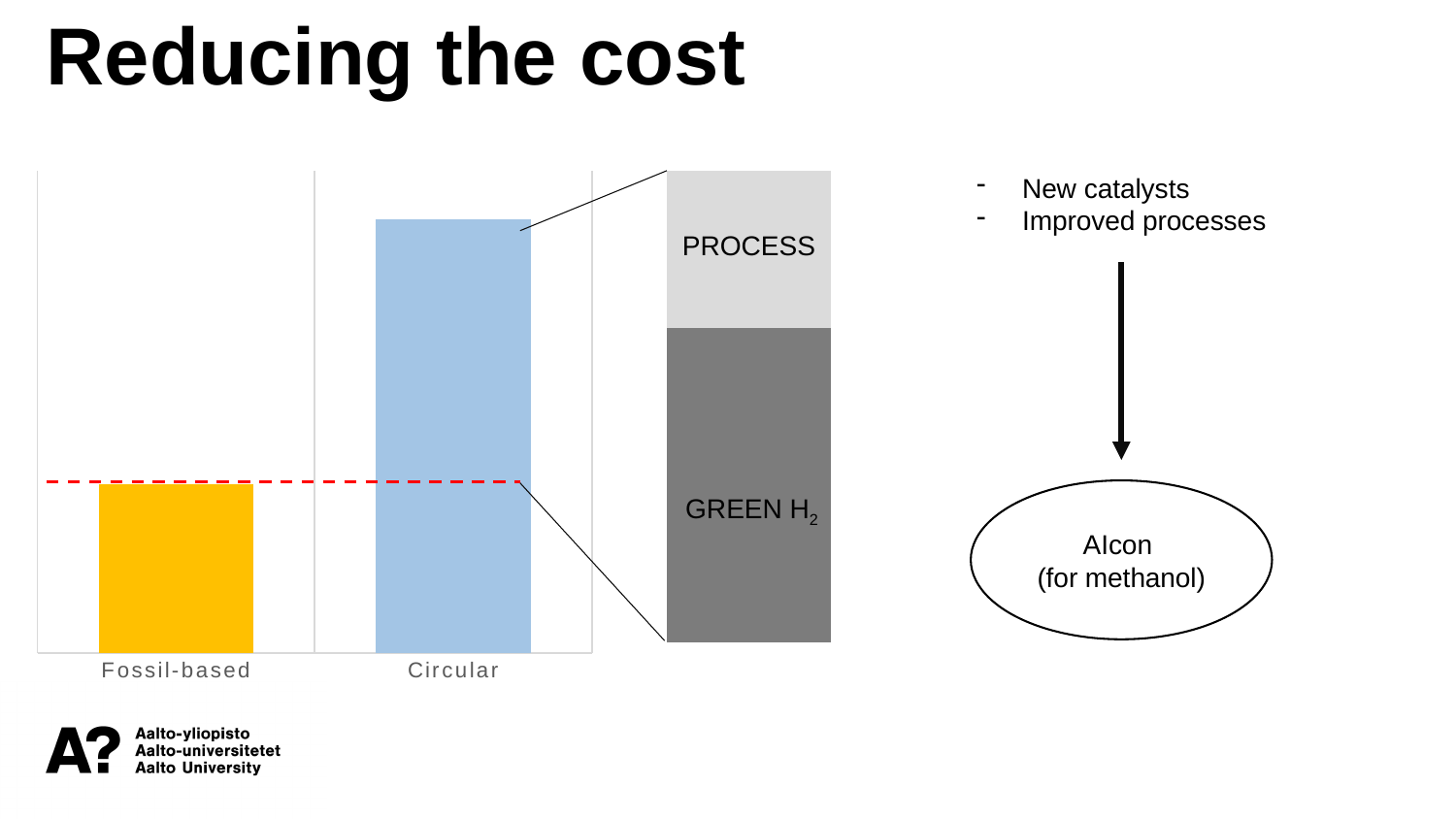
Which category has the highest bar in the chart? Circular Which category has the lowest bar in the chart? Fossil-based Which bar is taller, Fossil-based or Circular? Circular What kind of chart is shown on the slide? bar chart What are the two category labels on the x axis of the chart? Fossil-based and Circular What colour is the Fossil-based bar in the chart? yellow How many categories are shown on the x axis of the bar chart? 2 Is the Circular bar higher or lower than the Fossil-based bar? higher